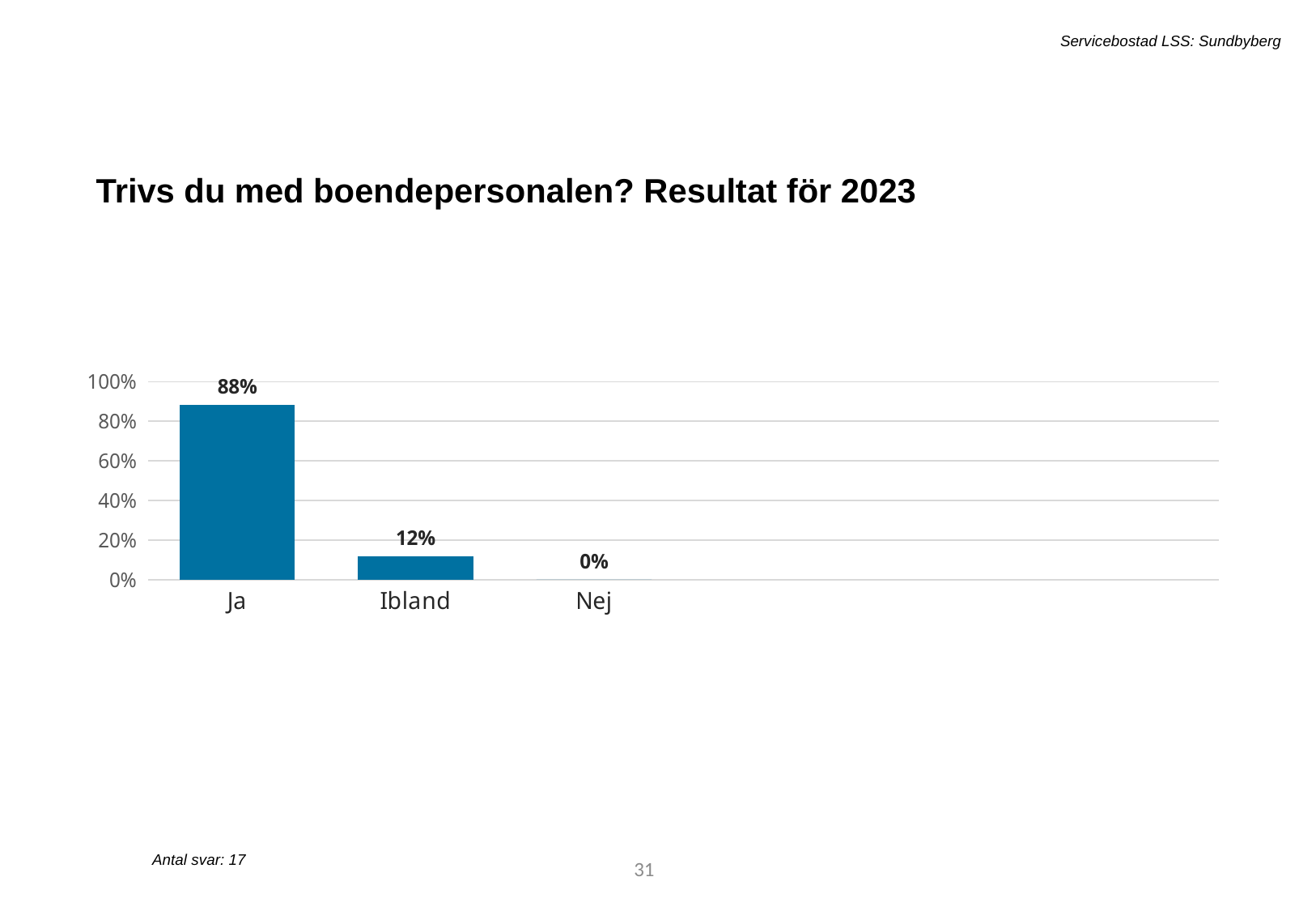
Which category has the highest value? Ja Which category has the lowest value? Nej Do the values rise or fall from left to right along the x axis? fall What kind of chart is shown on the slide? bar chart What is the value for Nej? 0% What is the difference between the values for Ja and Ibland? 76% How many categories are shown on the x axis? 3 What is the value for Ja? 88% Is the value for Ja greater or less than 80%? greater How many responses (Antal svar) does the slide report? 17 What is the value for Ibland? 12% Which is larger, the value for Ibland or the value for Nej? Ibland